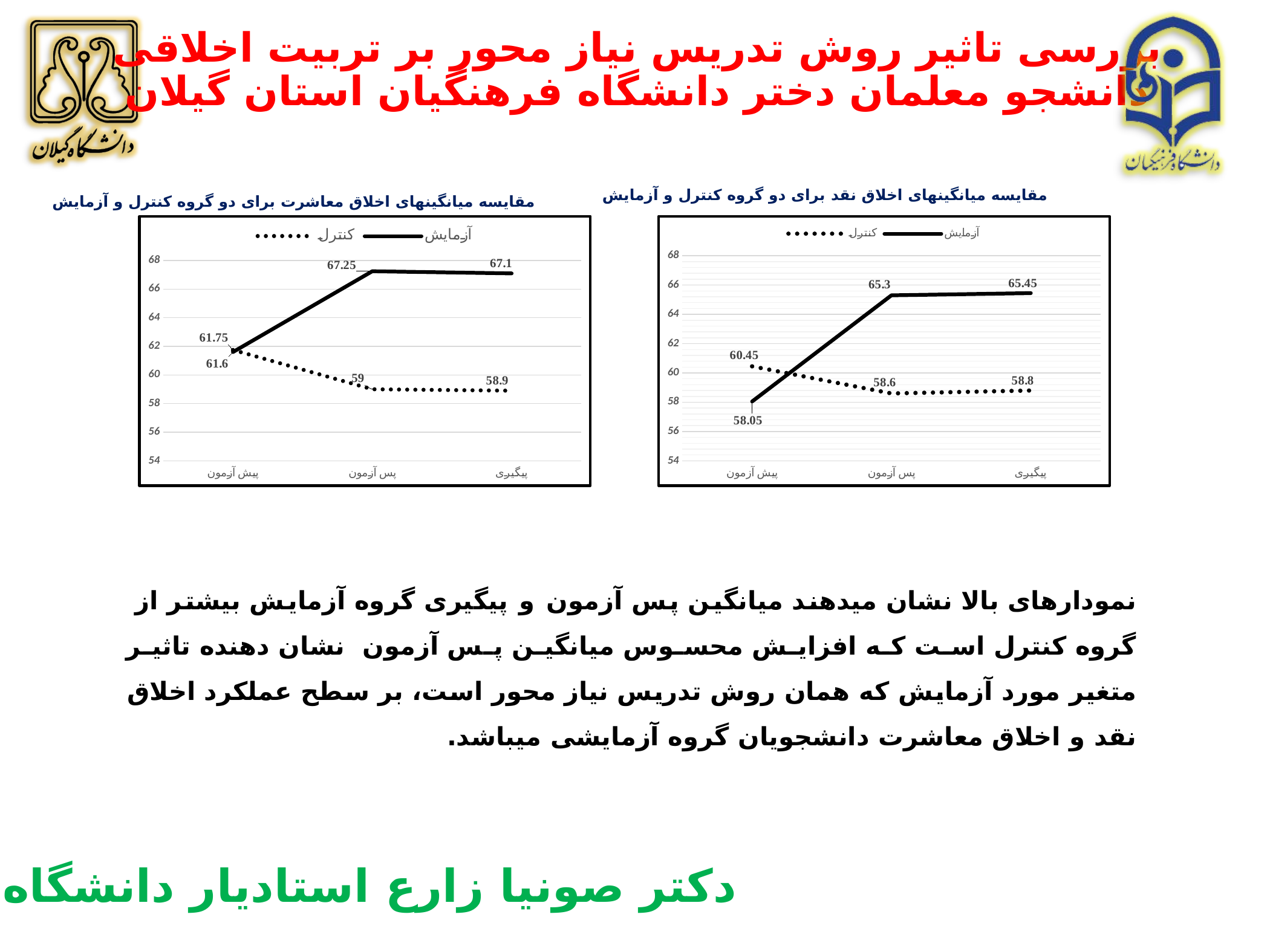
In the right chart (اخلاق نقد), what is the difference between the آزمایش and کنترل values at پیگیری? 6.65 In the right chart (اخلاق نقد), what is the value of the کنترل series at پیش آزمون? 60.45 In the left chart (اخلاق معاشرت), what is the value of the آزمایش series at پیگیری? 67.1 How many categories are shown on the x axis of the left chart (اخلاق معاشرت)? 3 In the right chart (اخلاق نقد), which series has the higher value at پیش آزمون, آزمایش or کنترل? کنترل In the left chart (اخلاق معاشرت), what is the value of the کنترل series at پس آزمون? 59 In the left chart (اخلاق معاشرت), what is the difference between the آزمایش value at پس آزمون and at پیگیری? 0.15 In the right chart (اخلاق نقد), at which category does the آزمایش series reach its lowest value? پیش آزمون In the left chart (اخلاق معاشرت), which series has the higher value at پس آزمون, آزمایش or کنترل? آزمایش What type of chart is the left chart (اخلاق معاشرت)? Line chart In the right chart (اخلاق نقد), what is the value of the آزمایش series at پس آزمون? 65.3 How many series does the legend of the right chart (اخلاق نقد) list? 2